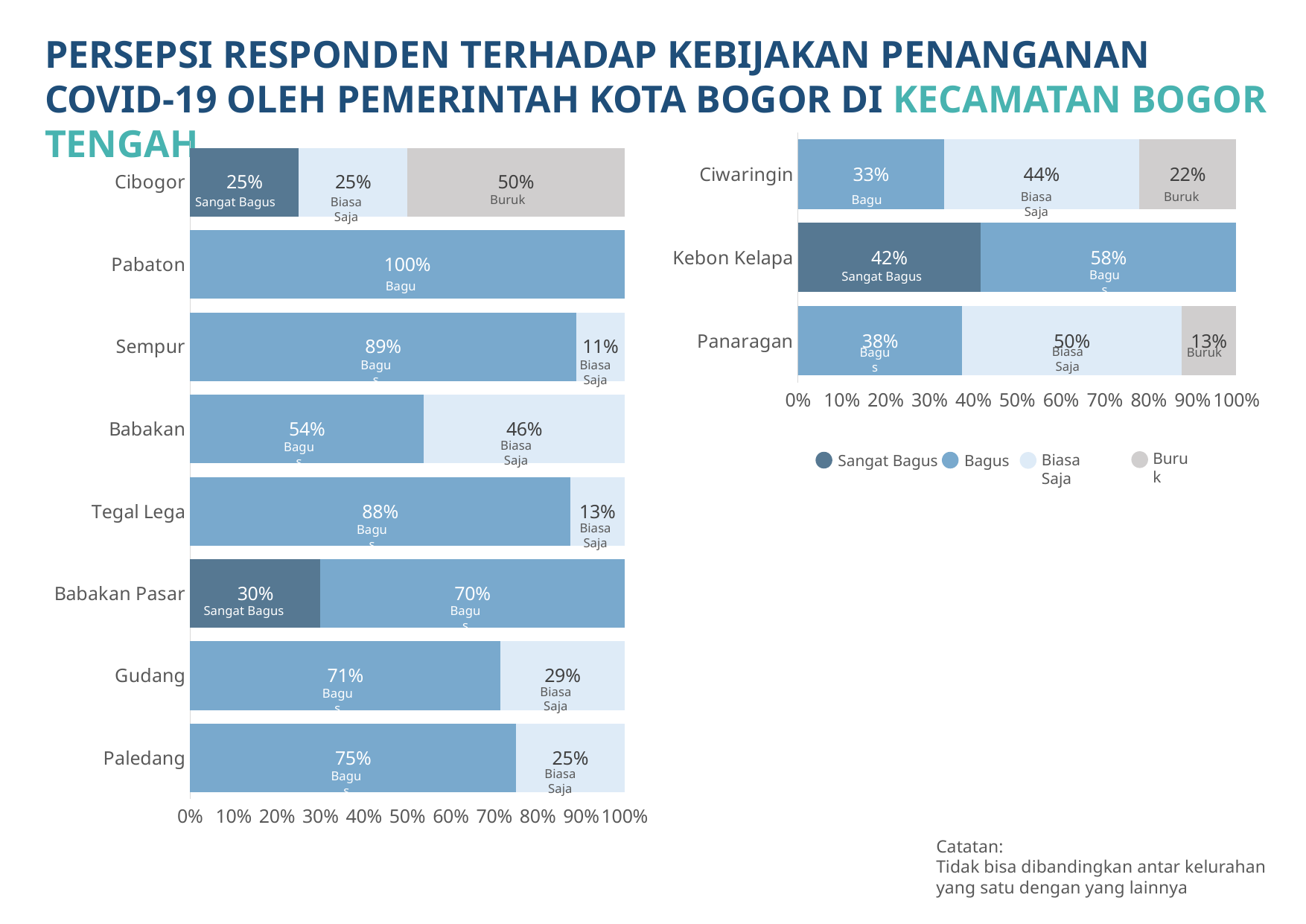
In the left chart, what percentage of respondents in Pabaton rated the policy as Bagus? 100% In the left chart, which kelurahan has the highest Bagus percentage? Pabaton How many kelurahan are shown in the left chart? 8 In the right chart, which kelurahan has the highest Buruk percentage? Ciwaringin In the left chart, what is the difference between the Bagus percentage for Gudang and the Biasa Saja percentage for Gudang? 42% How many kelurahan are shown in the right chart? 3 In the left chart, which is larger: the Sangat Bagus percentage for Babakan Pasar or the Sangat Bagus percentage for Cibogor? Babakan Pasar In the left chart, what percentage of respondents in Cibogor rated the policy as Buruk? 50% In the right chart, what percentage of respondents in Panaragan rated the policy as Biasa Saja? 50% How many series does the legend list? 4 In the right chart, what percentage of respondents in Kebon Kelapa rated the policy as Sangat Bagus? 42% What type of chart is used on this slide? Stacked bar chart